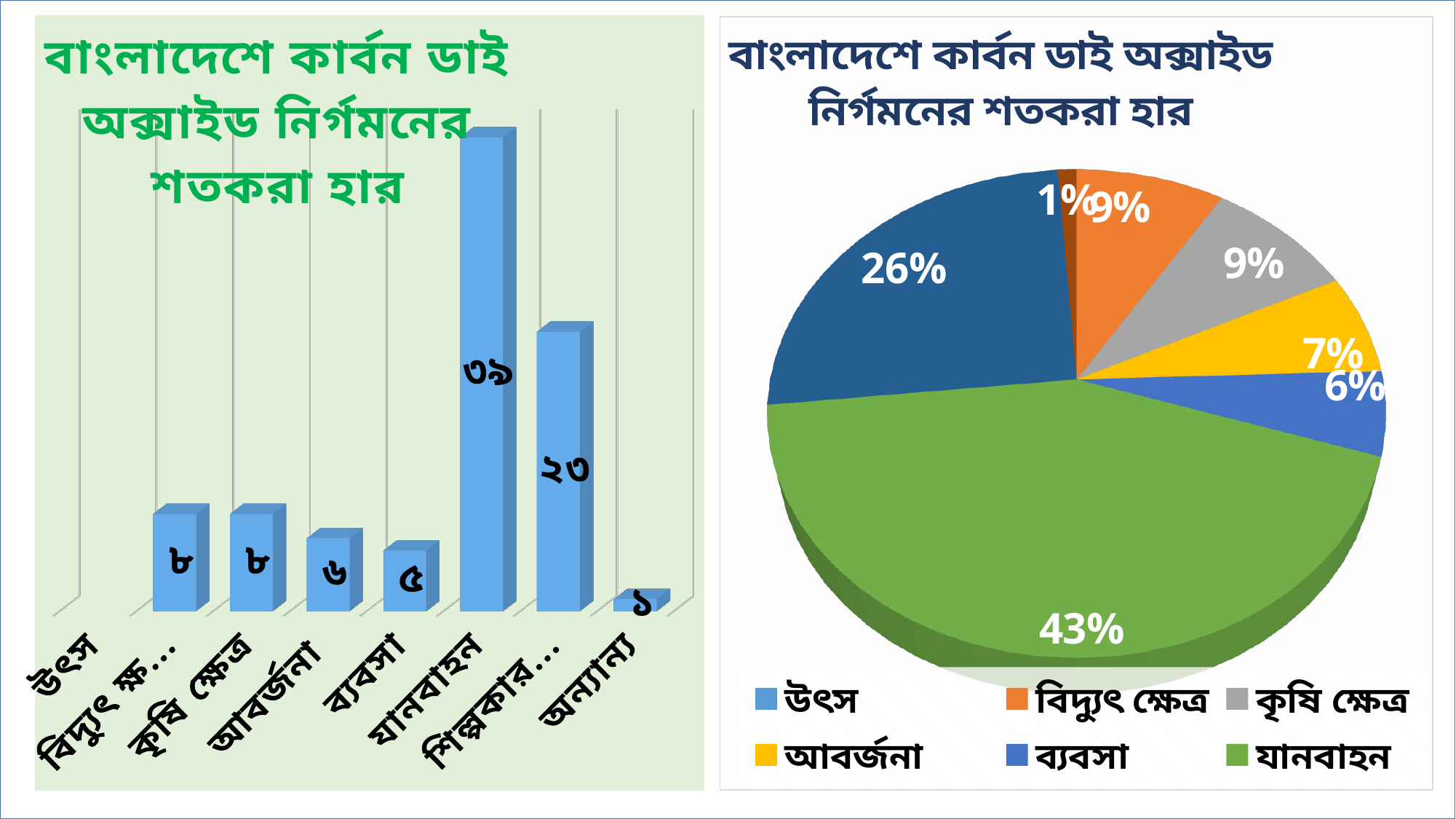
In the bar chart on the left, what is the difference between the values for যানবাহন and শিল্পকার...? ১৬ In the bar chart on the left, which is larger: the value for আবর্জনা or the value for ব্যবসা? আবর্জনা In the pie chart on the right, what is the share of the largest slice? 43% What kind of chart is the chart on the right side of the slide? pie chart How many entries does the legend of the pie chart on the right list? 6 How many categories are shown on the x axis of the bar chart on the left? 8 What kind of chart is the chart on the left side of the slide? bar chart In the bar chart on the left, which category has the tallest bar? যানবাহন In the bar chart on the left, what is the value for আবর্জনা? ৬ In the bar chart on the left, what is the value for কৃষি ক্ষেত্র? ৮ In the bar chart on the left, what is the value for যানবাহন? ৩৯ In the bar chart on the left, what is the value for ব্যবসা? ৫